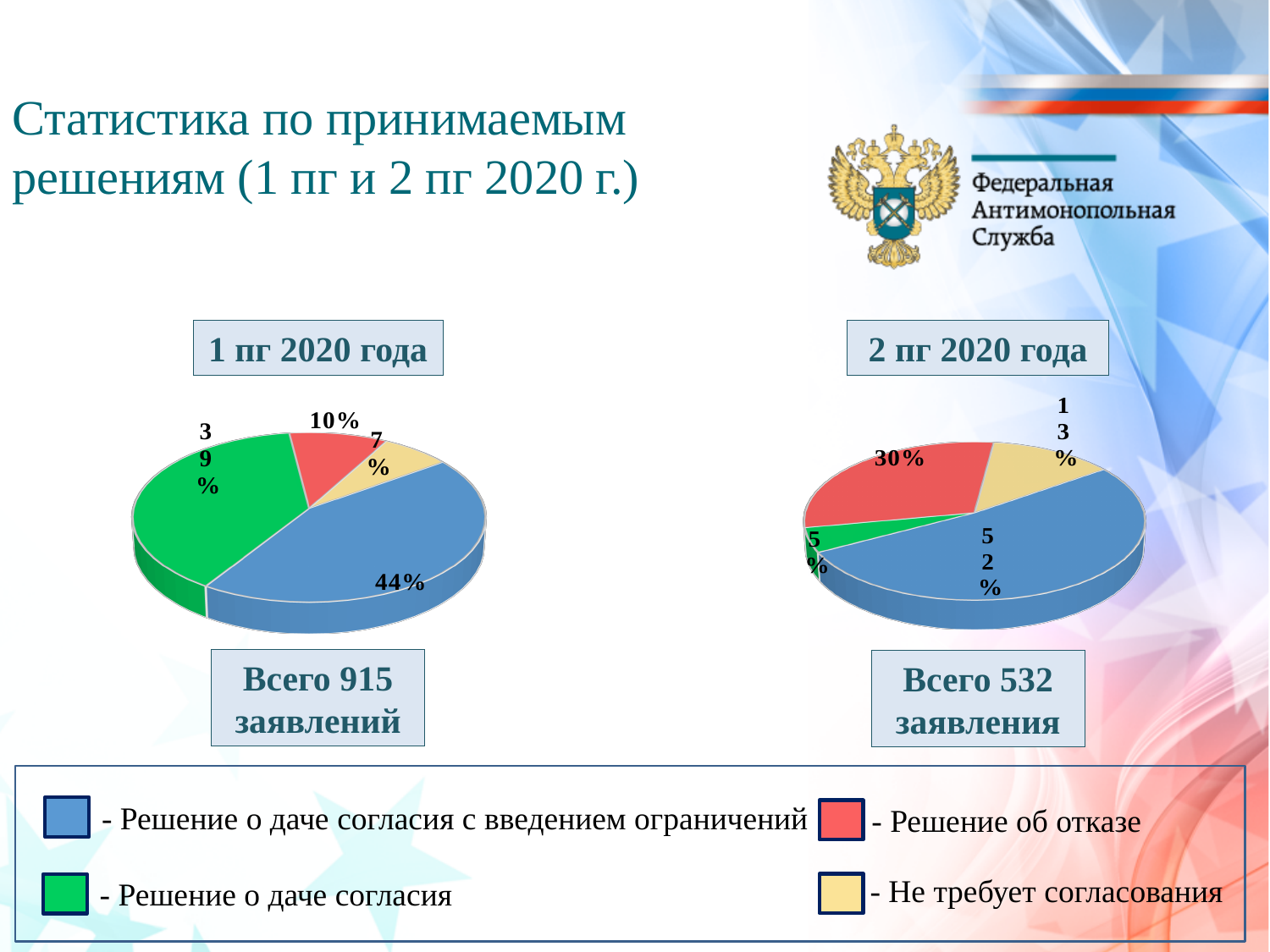
What is the difference between the share of "Решение об отказе" in the "2 пг 2020 года" chart and in the "1 пг 2020 года" chart? 20 percentage points In the "2 пг 2020 года" chart, which category has the largest share? Решение о даче согласия с введением ограничений What kind of chart is used for "1 пг 2020 года"? Pie chart In the "2 пг 2020 года" chart, what share is "Решение о даче согласия с введением ограничений" (blue)? 52% What total number of applications is shown under the "2 пг 2020 года" chart? Всего 532 заявления In the "1 пг 2020 года" chart, what share is "Решение об отказе" (red)? 10% In the "1 пг 2020 года" chart, what share is "Решение о даче согласия" (green)? 39% In the "1 пг 2020 года" chart, which category has the smallest share? Не требует согласования How many slices does the "1 пг 2020 года" pie chart have? 4 In the "2 пг 2020 года" chart, which category has the smallest share? Решение о даче согласия